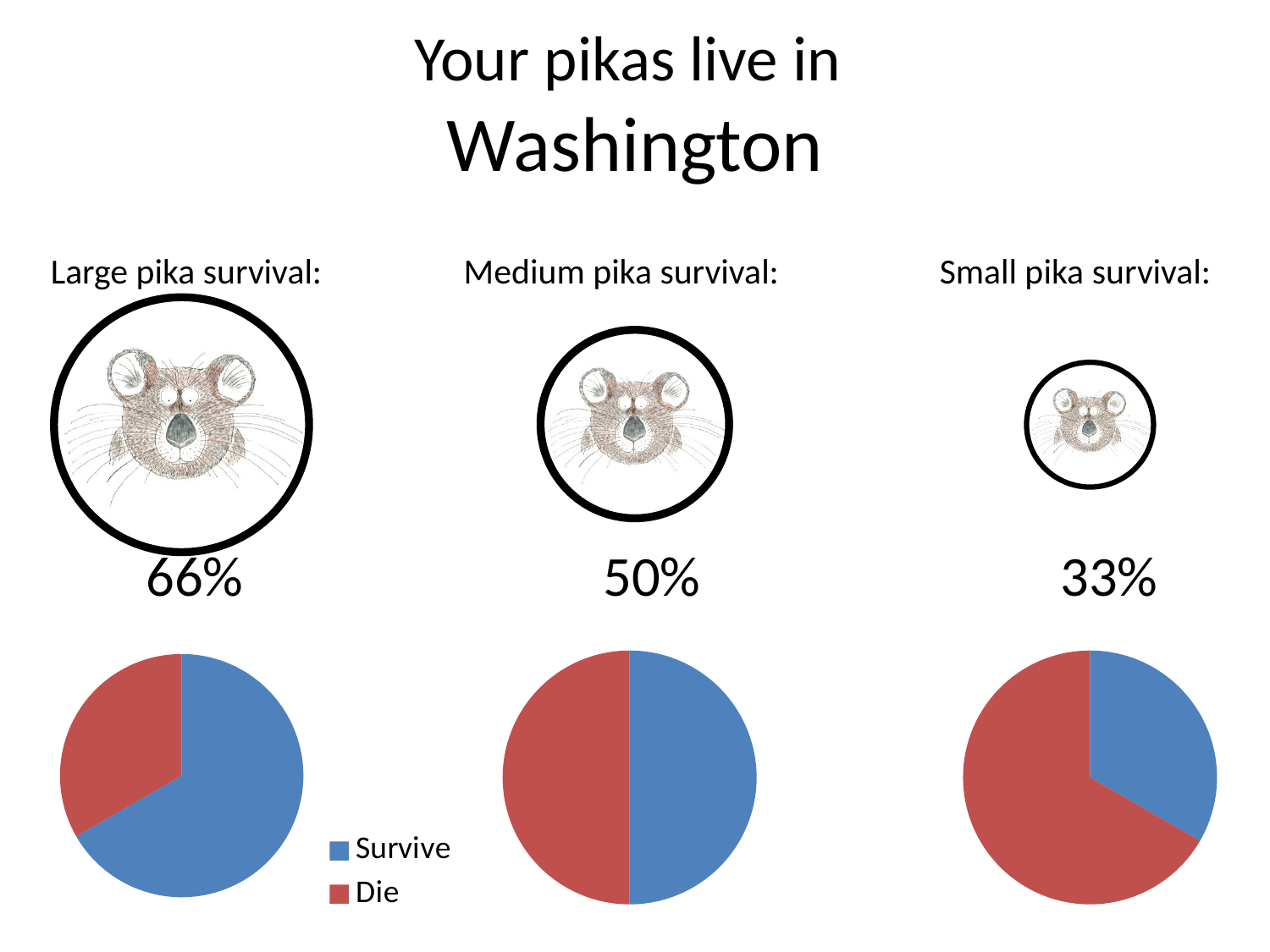
In the Medium pika survival pie chart, what share of the pie is the Die slice? 50% In the Large pika survival pie chart, which slice is larger, Survive or Die? Survive What colour represents the Survive slice in the pie charts? blue Across the three pie charts, which pika size has the lowest survival percentage? Small In the Small pika survival pie chart, what share of the pie is the Survive slice? 33% In the Large pika survival pie chart, what share of the pie is the Survive slice? 66% How many entries does the legend list for the pie charts? 2 What kind of chart is used to show the survival data for each pika size? pie chart In the Small pika survival pie chart, which slice is larger, Survive or Die? Die How many pie charts are shown on the slide? 3 Across the three pie charts, which pika size has the highest survival percentage? Large